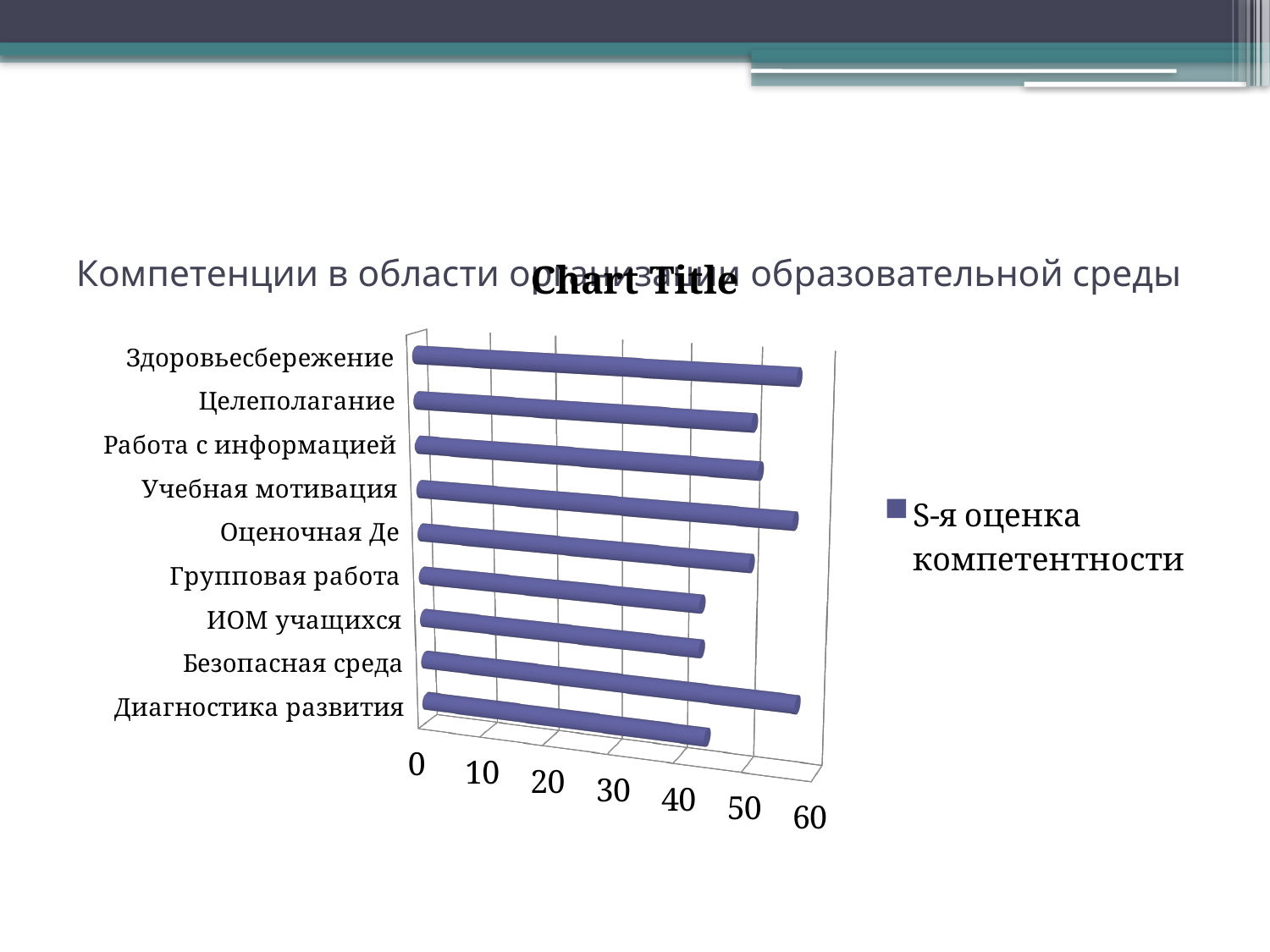
Is the value for ИОМ учащихся greater or less than 50? less Is the value for Групповая работа greater or less than 50? less Is the value for Диагностика развития greater or less than 50? less What kind of chart is shown on the slide? bar chart What is the name of the series shown in the legend? S-я оценка компетентности How many categories are plotted in the chart? 9 How many series does the chart legend list? 1 Which has the larger value, Безопасная среда or ИОМ учащихся? Безопасная среда Which has the larger value, Здоровьесбережение or Групповая работа? Здоровьесбережение What title is printed above the chart? Chart Title